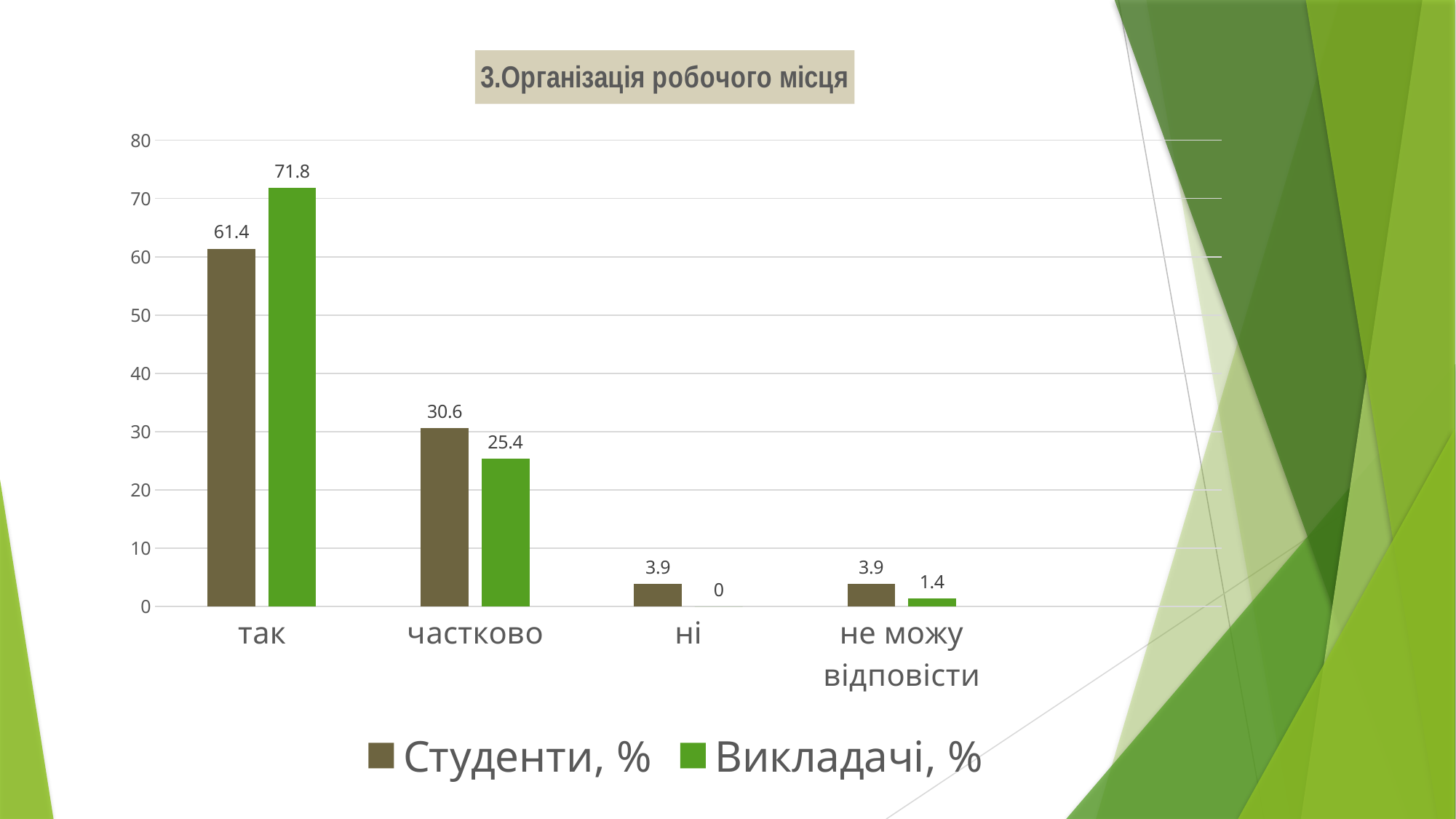
What is the value for Викладачі, % in the так category? 71.8 Which category has the highest value for Студенти, %? так How many categories are shown on the x axis? 4 What kind of chart is shown on the slide? bar chart In the частково category, which series has the larger value, Студенти, % or Викладачі, %? Студенти, % What is the difference between Викладачі, % and Студенти, % in the так category? 10.4 What is the title of the chart? 3.Організація робочого місця Which category has the lowest value for Викладачі, %? ні What is the value for Викладачі, % in the ні category? 0 What is the value for Студенти, % in the так category? 61.4 How many series does the legend list? 2 What is the value for Викладачі, % in the частково category? 25.4